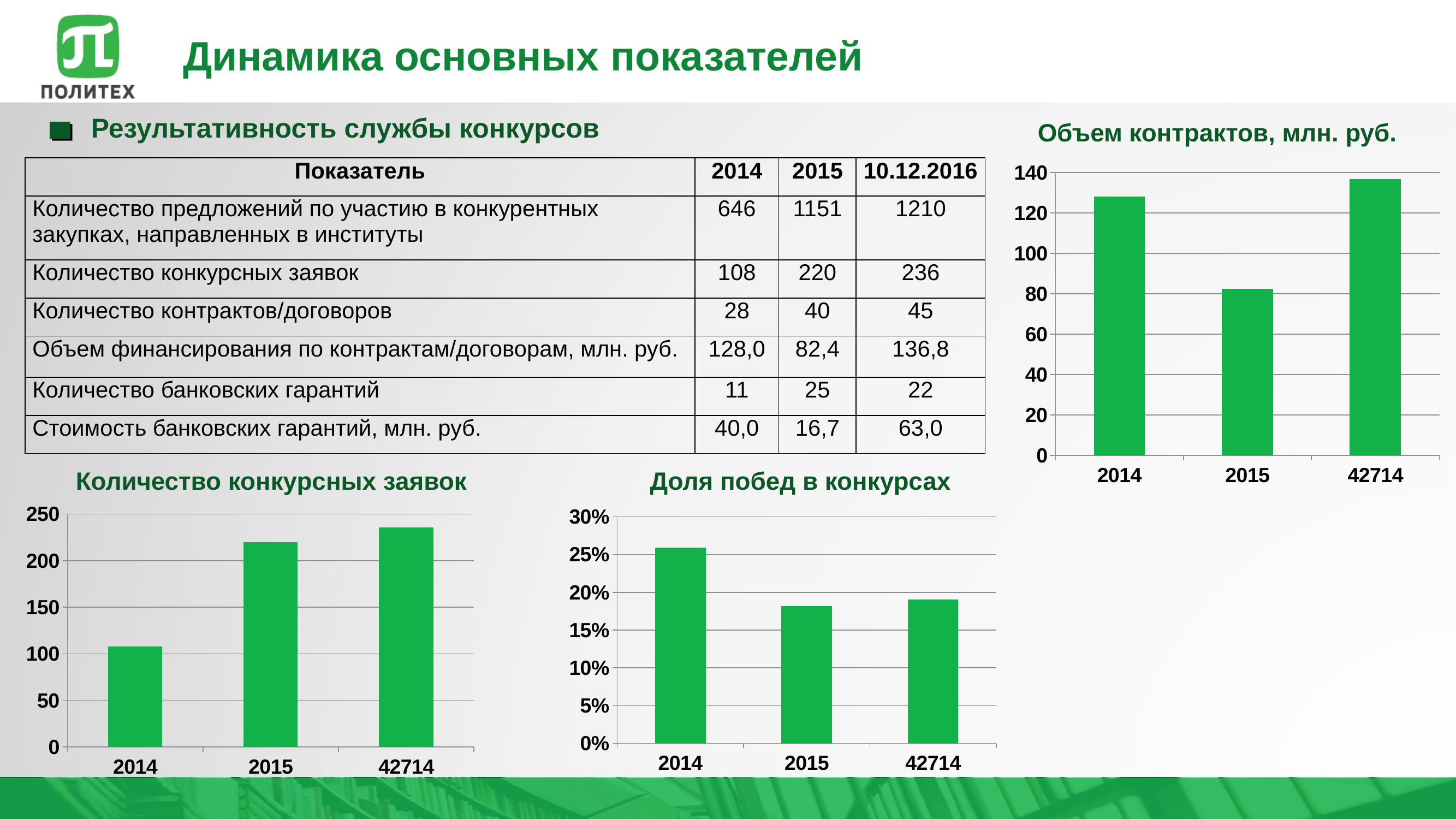
On the chart titled "Объем контрактов, млн. руб.", which category has the lowest bar? 2015 On the chart titled "Количество конкурсных заявок", is the value for 2015 greater or less than 200? greater On the chart titled "Доля побед в конкурсах", which category has the highest bar? 2014 On the chart titled "Объем контрактов, млн. руб.", is the value for 2014 greater or less than 120? greater On the chart titled "Количество конкурсных заявок", which category has the lowest bar? 2014 On the chart titled "Количество конкурсных заявок", how many bars are plotted? 3 What kind of chart is the one titled "Доля побед в конкурсах"? bar chart On the chart titled "Объем контрактов, млн. руб.", is the value for 2015 greater or less than 100? less On the chart titled "Количество конкурсных заявок", do the values rise or fall from 2014 to 42714? rise On the chart titled "Доля побед в конкурсах", which is larger, the value for 2014 or the value for 2015? 2014 On the chart titled "Объем контрактов, млн. руб.", which category has the highest bar? 42714